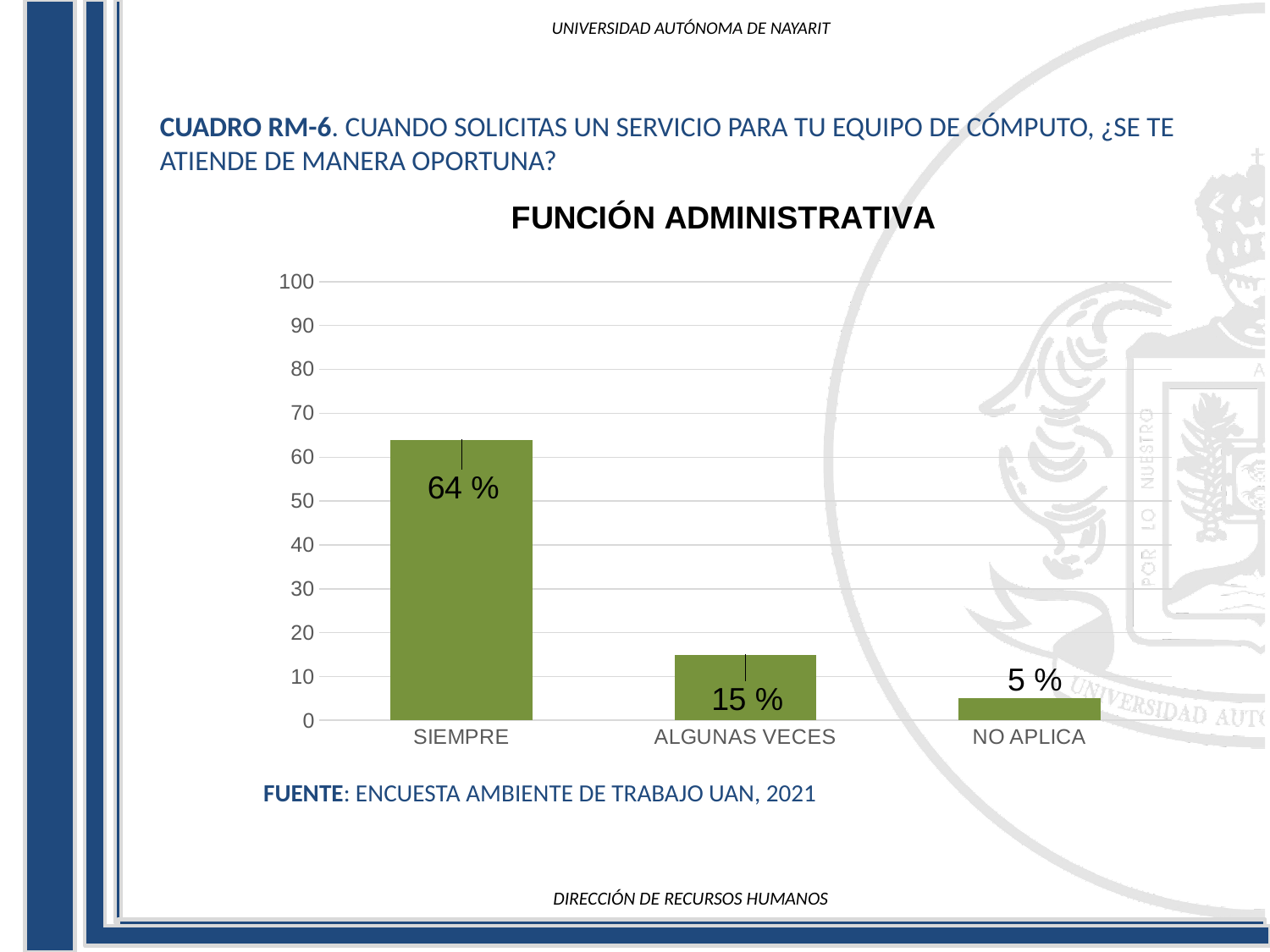
What is the value for SIEMPRE? 64 % What is the difference between the values for ALGUNAS VECES and NO APLICA? 10 % How many categories are shown on the x axis? 3 Is the value for SIEMPRE greater or less than 50? greater What is the value for NO APLICA? 5 % What is the difference between the values for SIEMPRE and ALGUNAS VECES? 49 % What kind of chart is shown on the slide? bar chart Which category has the lowest value? NO APLICA What is the title of the chart? FUNCIÓN ADMINISTRATIVA Which category has the highest value? SIEMPRE What is the value for ALGUNAS VECES? 15 % Which is larger, the value for ALGUNAS VECES or the value for NO APLICA? ALGUNAS VECES